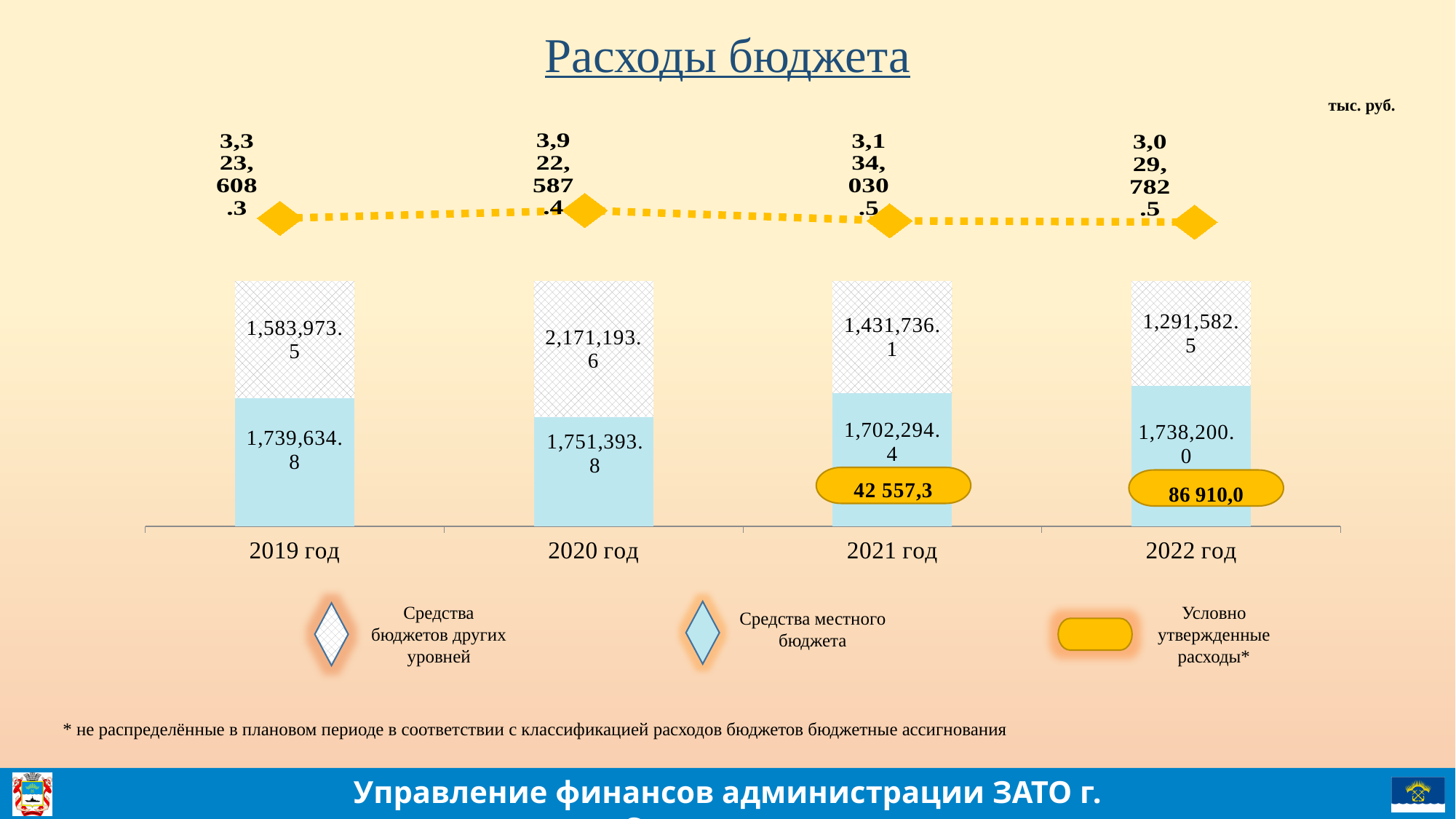
Which year has the highest total shown on the line? 2020 год Is Средства местного бюджета larger in 2020 год or in 2021 год? 2020 год Which year has the highest value of Средства бюджетов других уровней? 2020 год What unit of measurement is indicated in the top right corner of the chart? тыс. руб. What is the value of Средства бюджетов других уровней for 2020 год? 2,171,193.6 What total is shown on the line marker for 2021 год? 3,134,030.5 Which year has the lowest value of Средства бюджетов других уровней? 2022 год What type of chart is shown on the slide? stacked bar chart with a line How many years are shown on the x axis of the chart? 4 What is the difference between Условно утвержденные расходы in 2022 год and 2021 год? 44 352,7 What is the value of Средства местного бюджета for 2019 год? 1,739,634.8 What is the value of Условно утвержденные расходы for 2022 год? 86 910,0